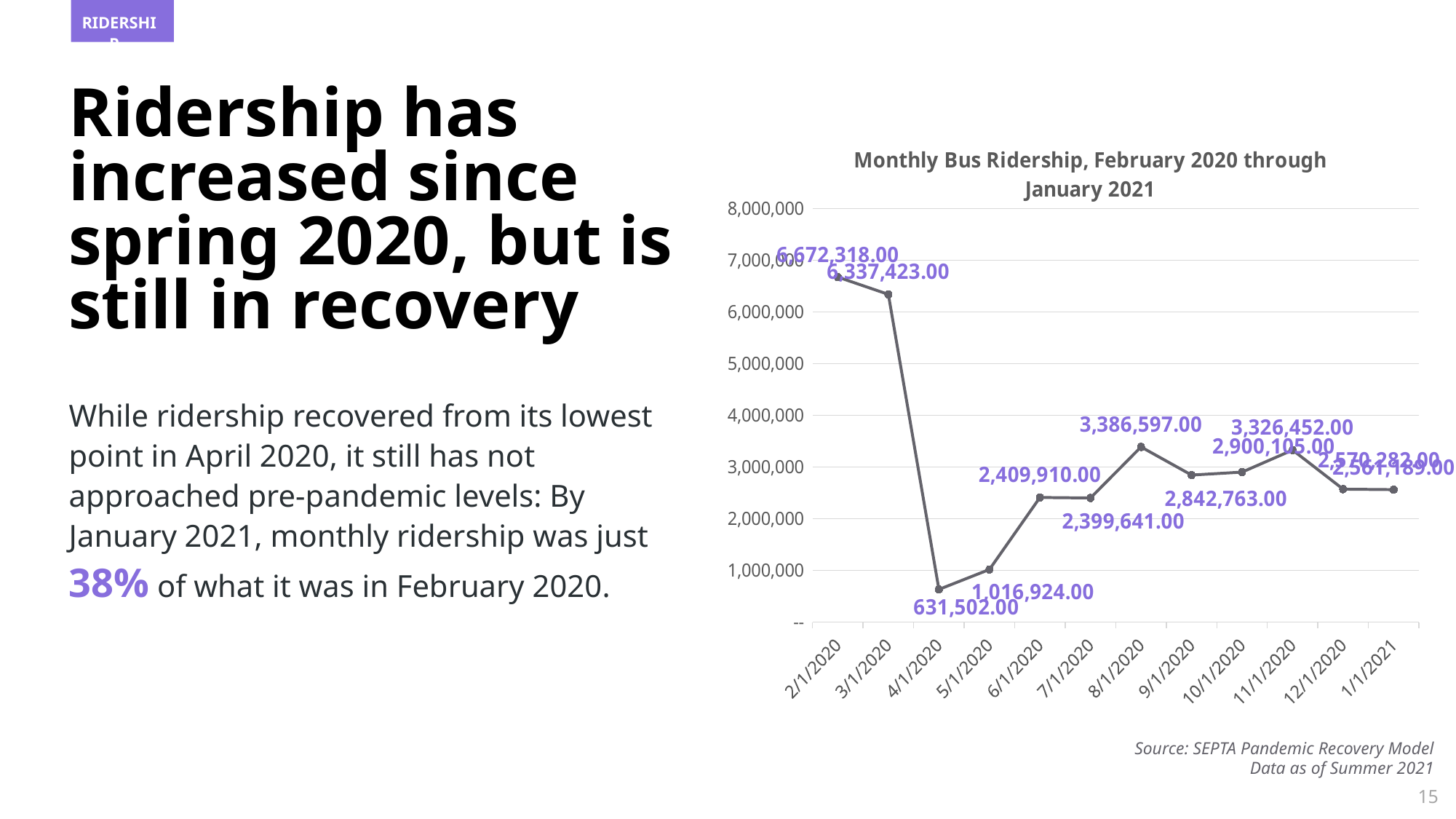
Is the ridership value for 5/1/2020 greater or less than 2,000,000? less What is the difference in ridership between 2/1/2020 and 3/1/2020? 334,895.00 Does ridership rise or fall from 4/1/2020 to 8/1/2020? rise What kind of chart is shown on the slide? line chart What is the difference in ridership between 8/1/2020 and 7/1/2020? 986,956.00 Which is larger, the ridership for 8/1/2020 or for 11/1/2020? 8/1/2020 What is the monthly bus ridership value for 2/1/2020? 6,672,318.00 Which month has the highest monthly bus ridership? 2/1/2020 What is the monthly bus ridership value for 8/1/2020? 3,386,597.00 Which month has the lowest monthly bus ridership? 4/1/2020 What is the monthly bus ridership value for 4/1/2020? 631,502.00 How many months are plotted on the chart? 12